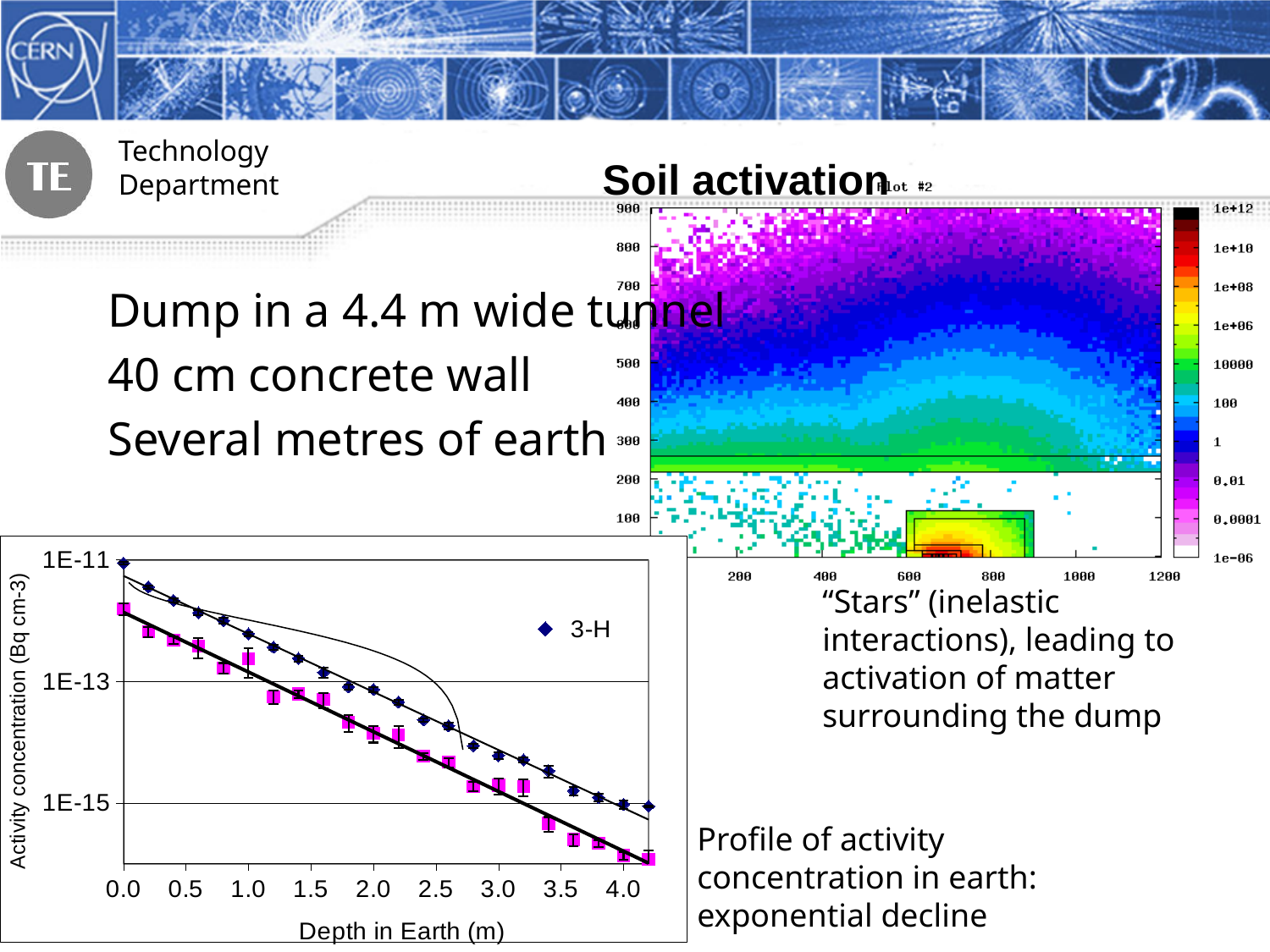
In the chart at the bottom left, what series name does the legend list? 3-H In the colour map chart at the top right, what is the lowest value shown on the colour scale? 1e-06 In the chart at the bottom left, how many series does the legend list? 1 In the chart at the bottom left, is the 3-H value at a depth of 1.0 m greater or less than 1E-13? greater In the colour map chart at the top right, what is the highest value shown on the colour scale? 1e+12 In the chart at the bottom left, do the 3-H values rise or fall as depth in earth increases? Fall In the chart at the bottom left, what is the label of the y axis? Activity concentration (Bq cm-3) In the chart at the bottom left, at a depth of 2.0 m, which is larger: the blue diamond (3-H) value or the magenta square value? The blue diamond (3-H) value In the chart at the bottom left, what is the largest depth tick shown on the x axis? 4.0 What kind of chart is shown at the bottom left of the slide? Scatter chart In the chart at the bottom left, what is the label of the x axis? Depth in Earth (m)